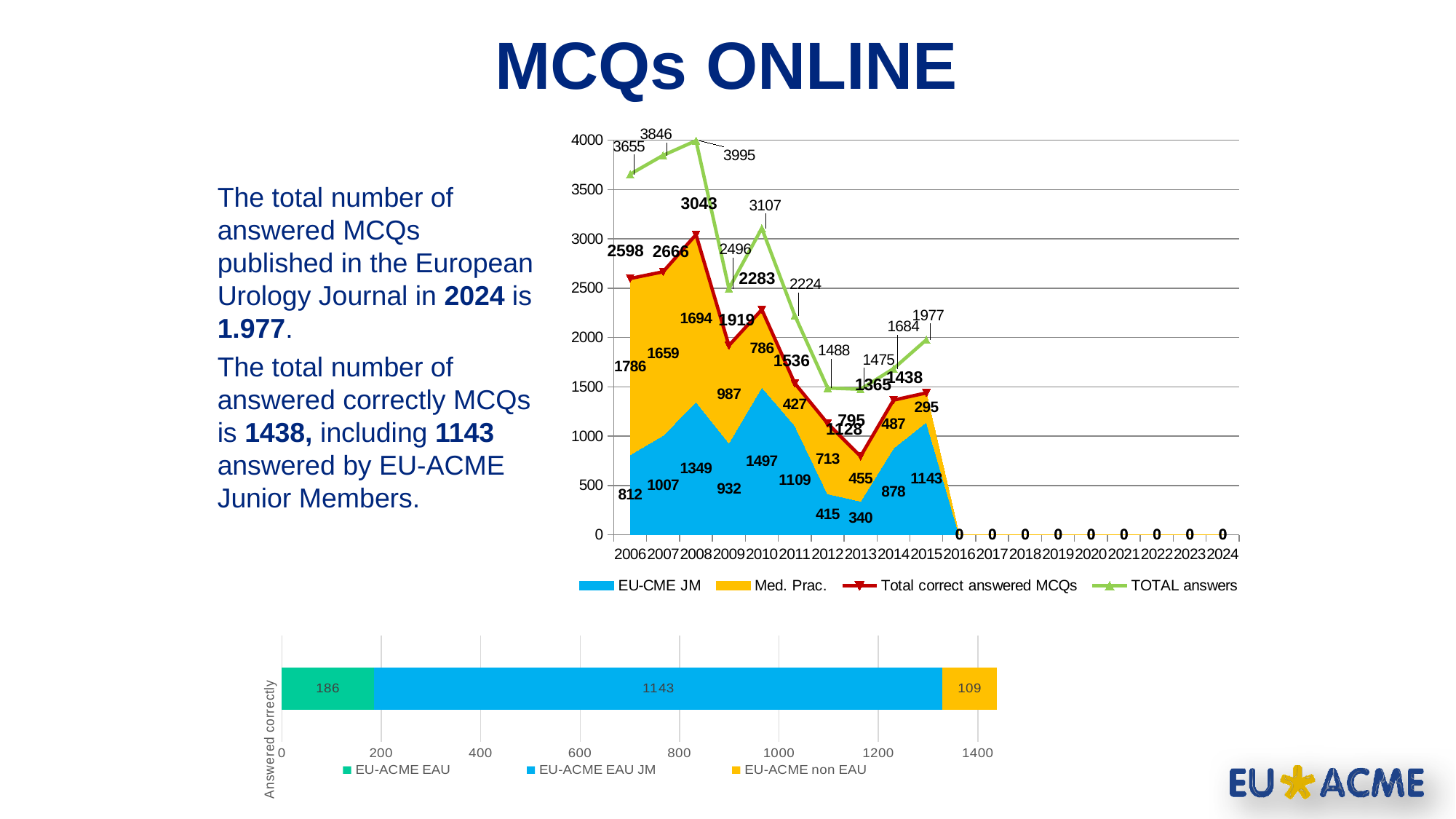
How many series does the legend of the top chart list? 4 How many series does the legend of the bottom chart list? 3 In the bottom stacked bar chart, what is the difference between the EU-ACME EAU and EU-ACME non EAU values? 77 In the bottom stacked bar chart, what is the total of the 'Answered correctly' bar? 1438 In the bottom stacked bar chart, what is the value for EU-ACME EAU? 186 In the top chart, which series is drawn in red? Total correct answered MCQs In the bottom stacked bar chart, what is the value for EU-ACME EAU JM? 1143 In the bottom stacked bar chart, which segment is the largest? EU-ACME EAU JM What kind of chart is the bottom chart on the slide? Stacked horizontal bar chart In the bottom stacked bar chart, which segment is the smallest? EU-ACME non EAU In the top chart, what is the highest value of the TOTAL answers series? 3995 In the bottom stacked bar chart, what is the value for EU-ACME non EAU? 109